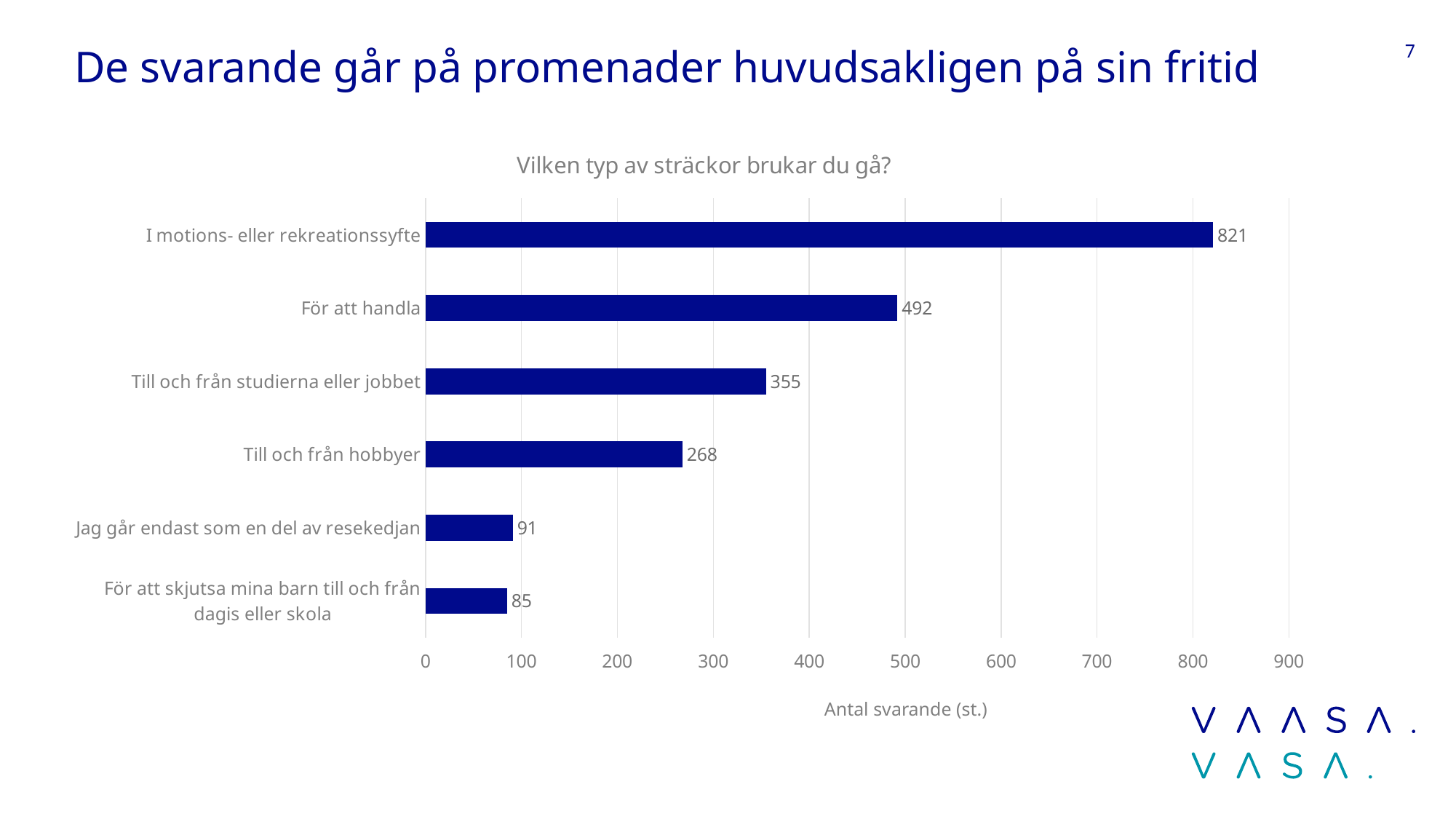
Which is larger: 'Till och från studierna eller jobbet' or 'Till och från hobbyer'? Till och från studierna eller jobbet What is the difference between 'I motions- eller rekreationssyfte' and 'För att handla'? 329 What is the value for 'Jag går endast som en del av resekedjan'? 91 Which category has the highest value? I motions- eller rekreationssyfte What kind of chart is shown on the slide? Bar chart What is the difference between 'Till och från studierna eller jobbet' and 'Till och från hobbyer'? 87 Which category has the lowest value? För att skjutsa mina barn till och från dagis eller skola How many respondents chose 'Till och från hobbyer'? 268 What is the value for 'För att handla'? 492 Is the value for 'För att handla' greater or less than 400? greater How many categories are shown in the chart? 6 What is the title of the chart? Vilken typ av sträckor brukar du gå?